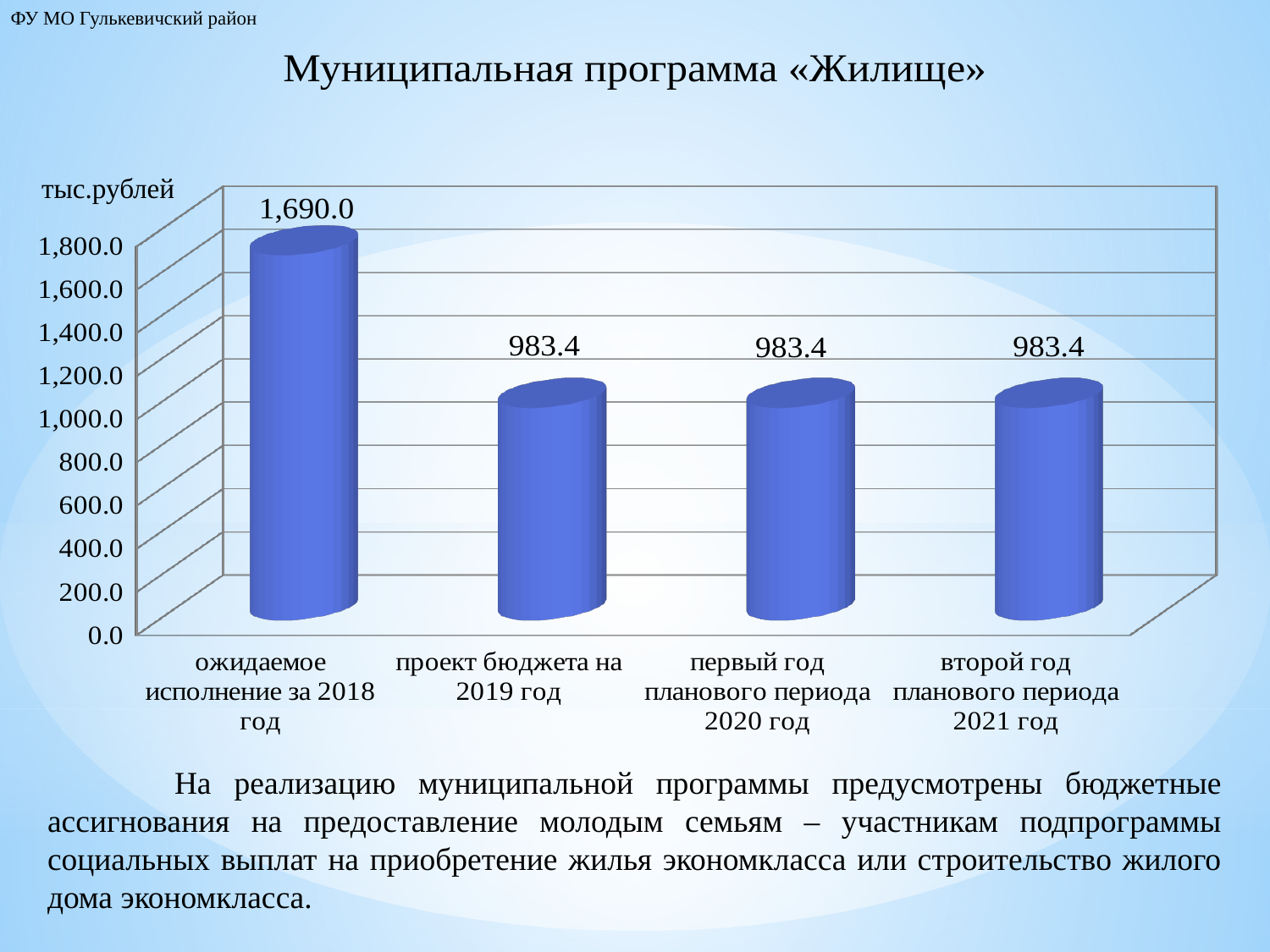
What is the value for 'ожидаемое исполнение за 2018 год'? 1,690.0 What is the difference between the value for 2018 (ожидаемое исполнение) and the value for 2019 (проект бюджета)? 706.6 What is the value for 'проект бюджета на 2019 год'? 983.4 How many categories are shown on the chart? 4 What kind of chart is shown on the slide? bar chart Which category has the highest value? ожидаемое исполнение за 2018 год Is the value for 'ожидаемое исполнение за 2018 год' greater or less than 1,600.0? greater Is the value for 'проект бюджета на 2019 год' greater or less than 1,000.0? less What is the value for 'первый год планового периода 2020 год'? 983.4 Which is larger: the value for 'ожидаемое исполнение за 2018 год' or the value for 'проект бюджета на 2019 год'? ожидаемое исполнение за 2018 год What unit of measurement is indicated for the chart values? тыс.рублей What is the value for 'второй год планового периода 2021 год'? 983.4